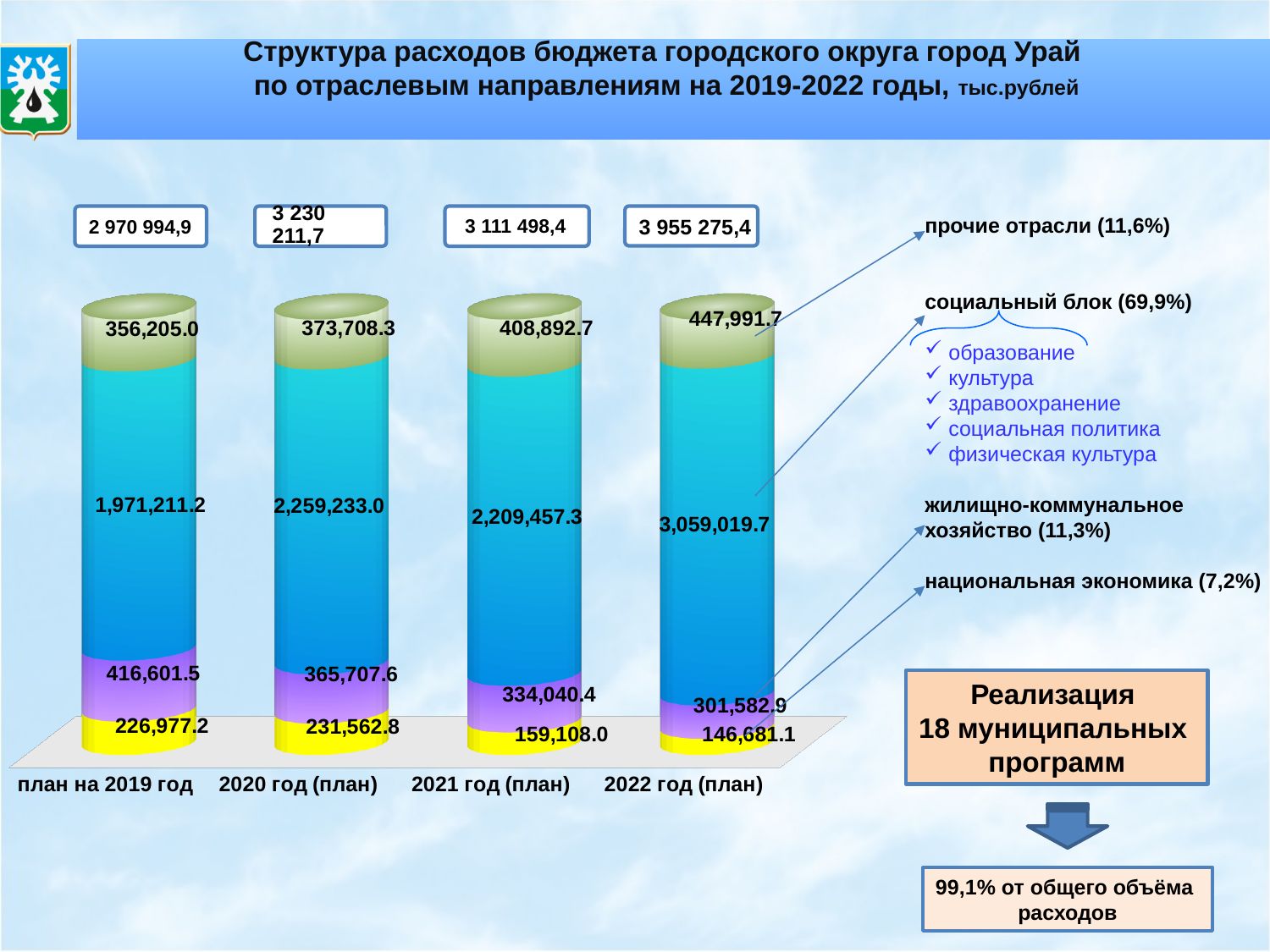
What is the value of the социальный блок segment for план на 2019 год? 1,971,211.2 Do the values of the purple segment (жилищно-коммунальное хозяйство) rise or fall from 2019 to 2022? fall Which year has the highest value for the социальный блок segment? 2022 год (план) What is the value of the yellow bottom segment (национальная экономика) for 2021 год (план)? 159,108.0 What is the difference between the top segment (прочие отрасли) values for 2022 год (план) and план на 2019 год? 91,786.7 What kind of chart is shown on the slide? bar chart How many categories (years) are plotted along the x axis? 4 Which year has the lowest value for the yellow bottom segment (национальная экономика)? 2022 год (план) What total is shown in the box above the bar for 2022 год (план)? 3 955 275,4 What is the value of the purple segment (жилищно-коммунальное хозяйство) for 2020 год (план)? 365,707.6 What is the value of the top segment (прочие отрасли) for 2022 год (план)? 447,991.7 Which is larger: the социальный блок value for 2020 год (план) or for 2021 год (план)? 2020 год (план)